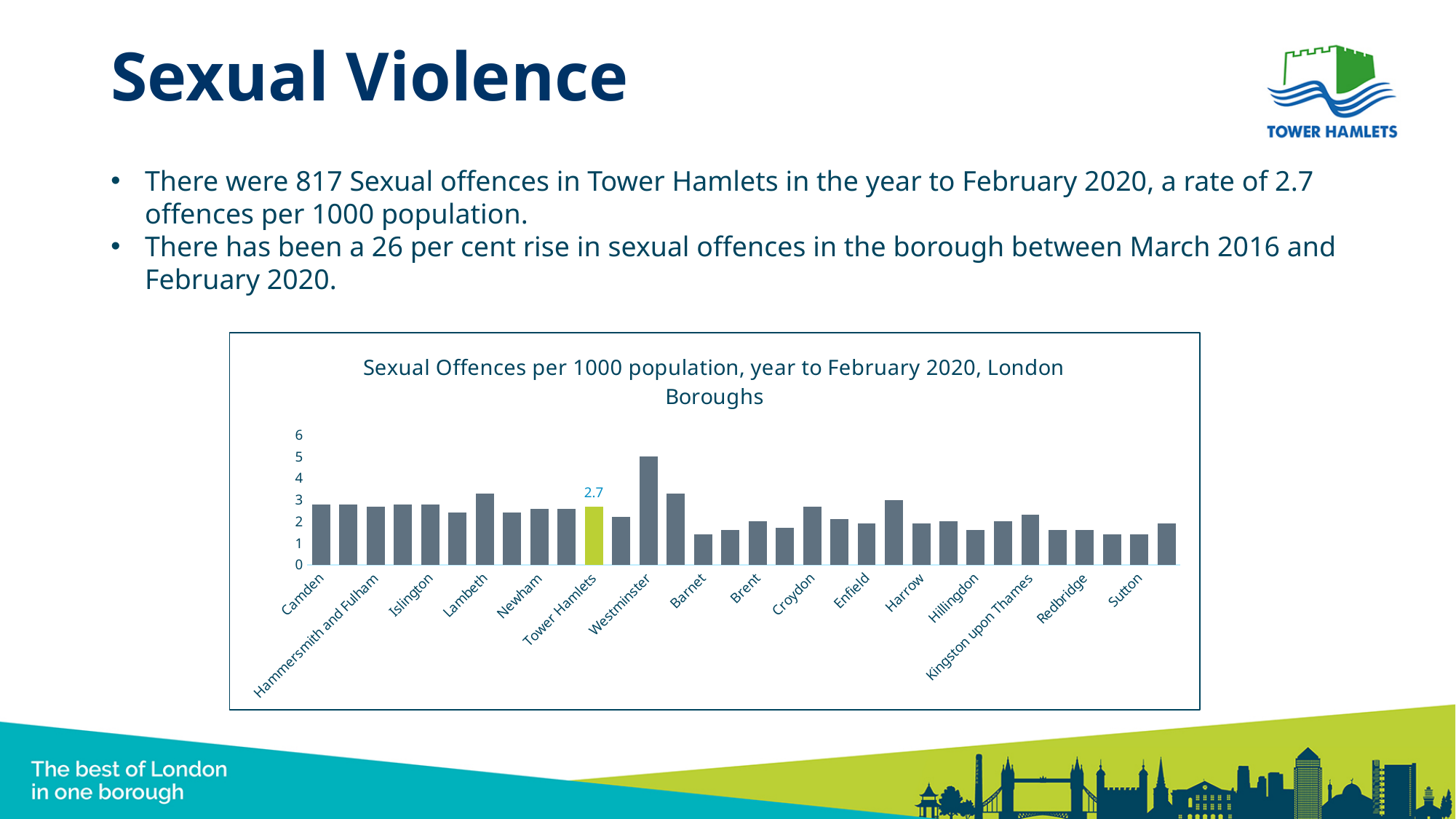
Which bar in the chart is highlighted in a different colour (green) from the others? Tower Hamlets Is the value for Sutton greater or less than 2? less Is the value for Barnet greater or less than 2? less Is the value for Croydon greater or less than 2? greater What type of chart is shown on the slide? bar chart Which borough has the highest value in the chart? Westminster Which has a higher value, Tower Hamlets or Barnet? Tower Hamlets What is the value shown for Tower Hamlets in the chart? 2.7 Which has a higher value, Westminster or Tower Hamlets? Westminster Which has a higher value, Lambeth or Sutton? Lambeth What is the title of the chart? Sexual Offences per 1000 population, year to February 2020, London Boroughs